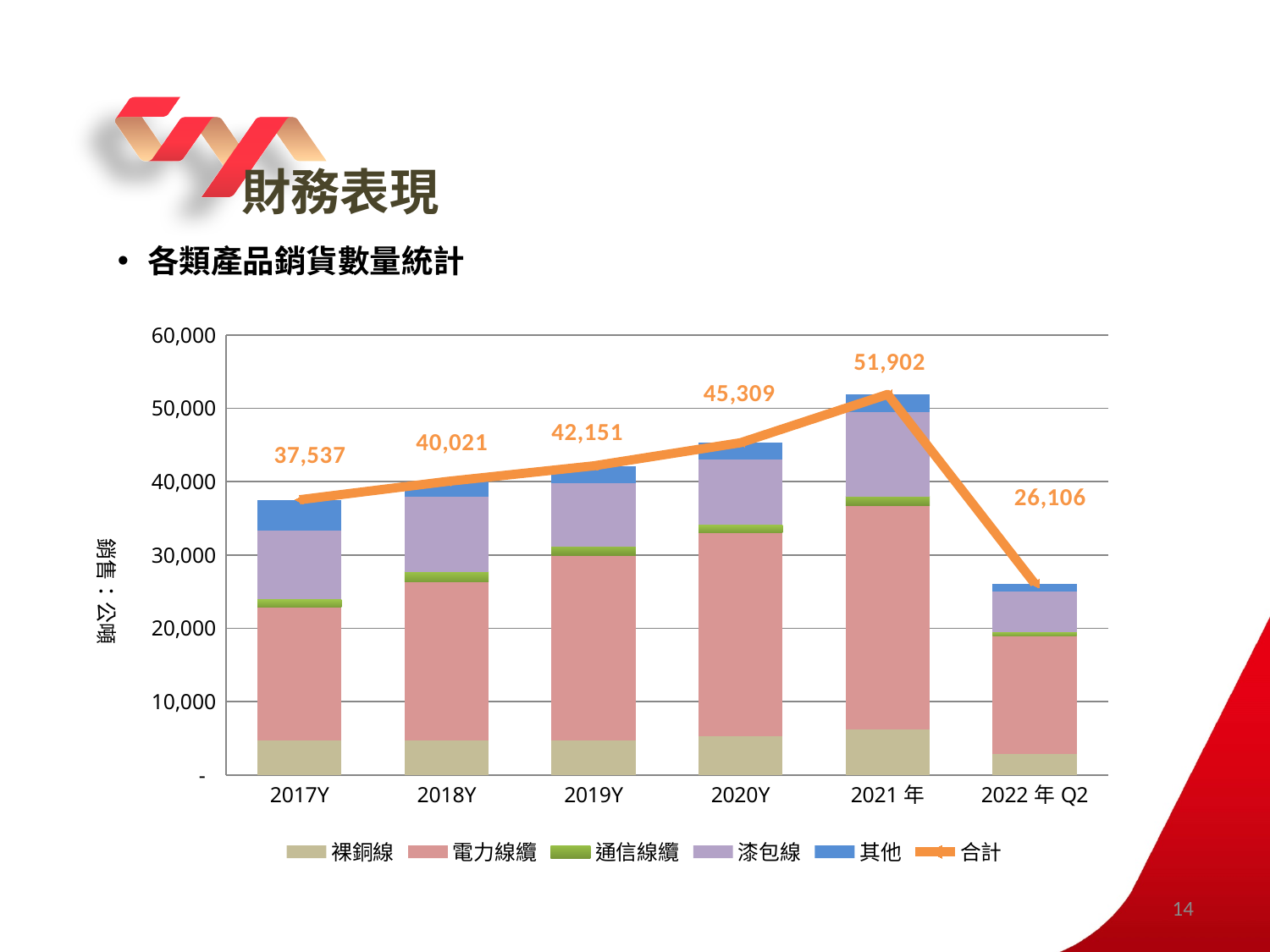
What is the 合計 value for 2022 年 Q2? 26,106 What is the 合計 value for 2017Y? 37,537 What is the 合計 value for 2021 年? 51,902 How many time periods are shown on the x axis? 6 How many series does the legend list? 6 What is the difference between the 合計 values for 2021 年 and 2020Y? 6,593 Which period has the highest 合計 value? 2021 年 What kind of chart is this? Stacked bar chart with a line Which period has the lowest 合計 value? 2022 年 Q2 Is the 裸銅線 value for 2017Y greater or less than 10,000? less Which is larger, the 合計 value for 2019Y or for 2018Y? 2019Y Does the 合計 value rise or fall from 2017Y to 2021 年? rise